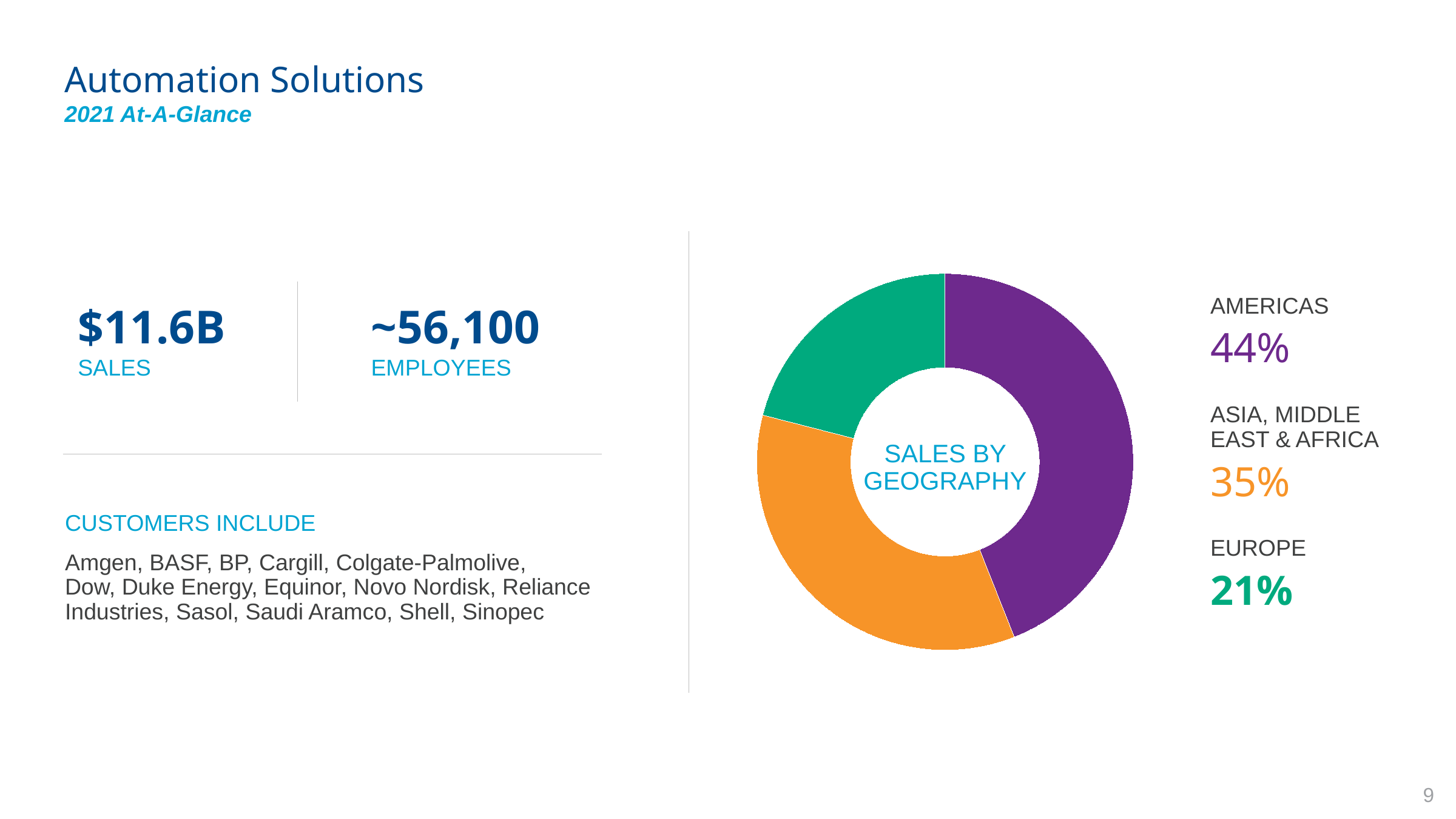
Which region has the smallest share of sales in the Sales by Geography chart? Europe Which has a larger share of sales: Asia, Middle East & Africa or Europe? Asia, Middle East & Africa What colour is the Europe segment in the Sales by Geography chart? Green What text appears in the centre of the donut chart? SALES BY GEOGRAPHY What is the difference in percentage points between the Americas and Europe shares in the Sales by Geography chart? 23 How many regions are shown in the Sales by Geography chart? 3 What share of sales does Europe account for in the Sales by Geography chart? 21% What is the difference in percentage points between the Americas and Asia, Middle East & Africa shares in the Sales by Geography chart? 9 What kind of chart is the Sales by Geography chart? Pie chart (donut) What share of sales does Asia, Middle East & Africa account for in the Sales by Geography chart? 35% What share of sales does the Americas account for in the Sales by Geography chart? 44% Which region has the largest share of sales in the Sales by Geography chart? Americas